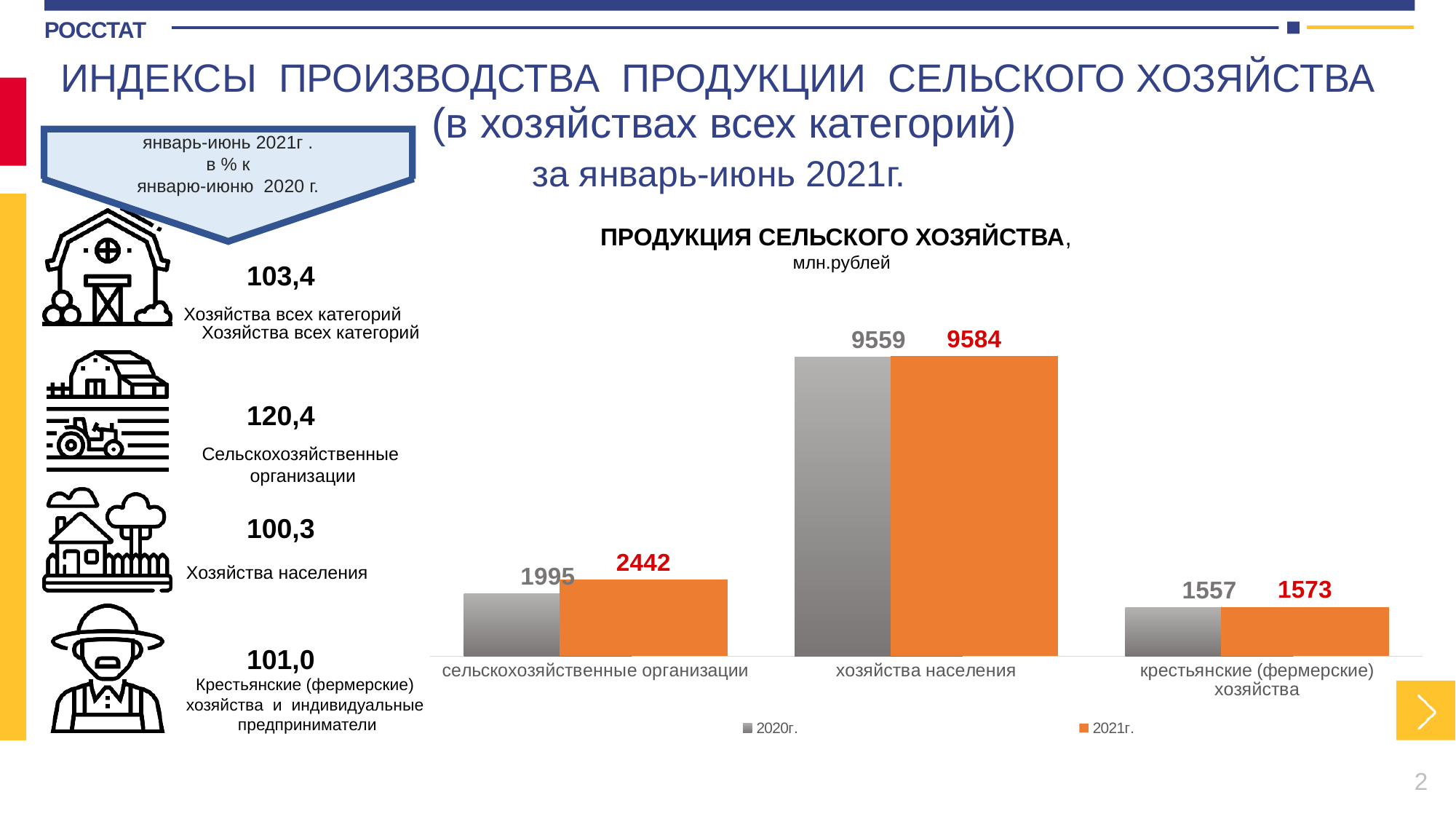
What unit is given in the chart subtitle? млн.рублей What is the difference between the 2021г. and 2020г. values for хозяйства населения? 25 How many categories are shown on the x axis of the chart? 3 What is the value for крестьянские (фермерские) хозяйства in 2021г.? 1573 How many series does the chart legend list? 2 Which category has the lowest value in 2020г.? крестьянские (фермерские) хозяйства What is the value for сельскохозяйственные организации in 2020г.? 1995 What is the difference between the 2021г. and 2020г. values for сельскохозяйственные организации? 447 What is the value for хозяйства населения in 2021г.? 9584 Which is larger for сельскохозяйственные организации: the 2020г. value or the 2021г. value? 2021г. Which category has the highest value in 2021г.? хозяйства населения What kind of chart is shown on the slide? bar chart